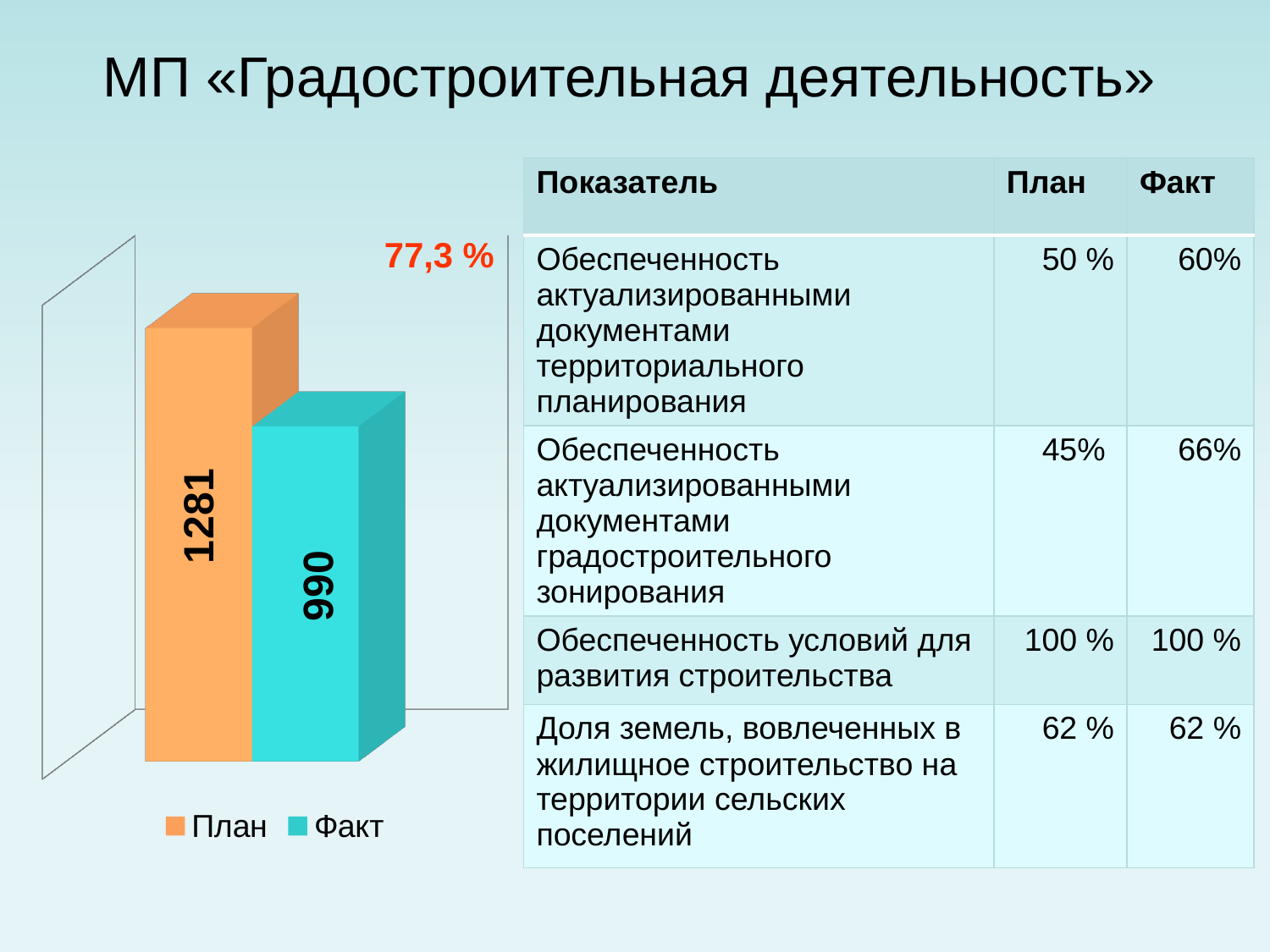
What kind of chart is shown on the slide? Bar chart How many bars are plotted in the chart? 2 What is the value of the Факт bar in the chart? 990 How many series does the chart legend list? 2 What is the value of the План bar in the chart? 1281 Which bar in the chart is taller, План or Факт? План Which series has the highest value in the chart? План What is the difference between the План and Факт values in the chart? 291 What percentage is printed in red above the chart? 77,3 % Which series has the lowest value in the chart? Факт What colour is the Факт bar in the chart? Turquoise